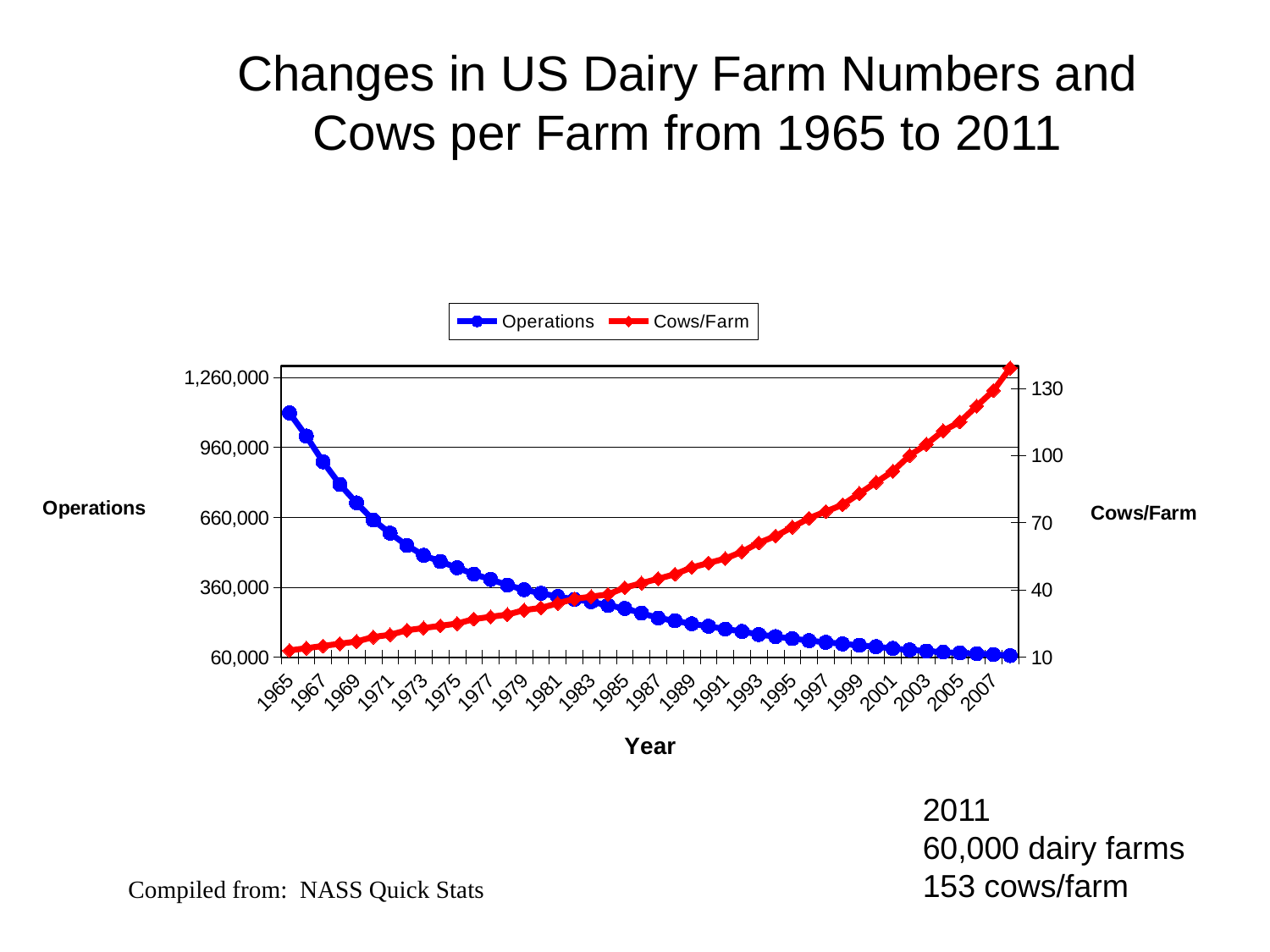
What are the two series named in the legend? Operations and Cows/Farm Is the Operations value for 1975 greater or less than 660,000? less What is the title of the x axis? Year What kind of chart is shown on the slide? Line chart Is the Operations value for 1965 greater or less than 960,000? greater Is the Cows/Farm value for 1965 greater or less than 40? less Which is larger, the Operations value in 1965 or in 2007? 1965 How many series does the legend list? 2 Does the Cows/Farm series rise or fall from 1965 to 2007? Rise In which year is the Cows/Farm value lowest? 1965 Does the Operations series rise or fall from 1965 to 2007? Fall In which year is the Operations value highest? 1965